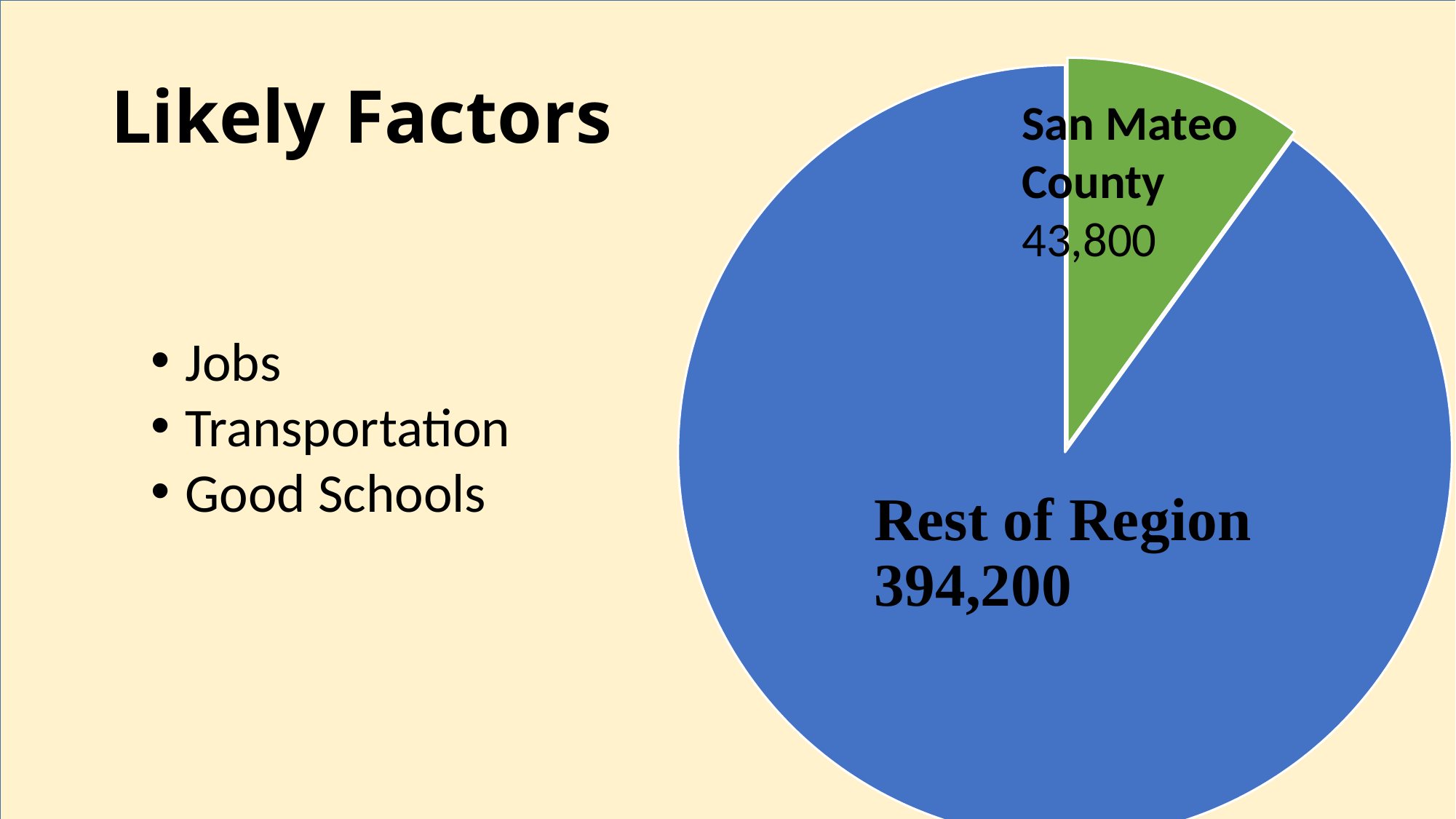
How many slices does the pie chart have? 2 Which slice of the pie chart is the smallest? San Mateo County What is the total of the two values shown in the pie chart? 438,000 What is the value for San Mateo County in the pie chart? 43,800 What is the value for Rest of Region in the pie chart? 394,200 Which slice of the pie chart is the largest? Rest of Region What colour is the San Mateo County slice in the pie chart? green What share of the pie does Rest of Region represent? 90% What kind of chart is shown on the slide? pie chart Which is larger, the value for San Mateo County or the value for Rest of Region? Rest of Region What is the difference between the Rest of Region value and the San Mateo County value? 350,400 What share of the pie does San Mateo County represent? 10%